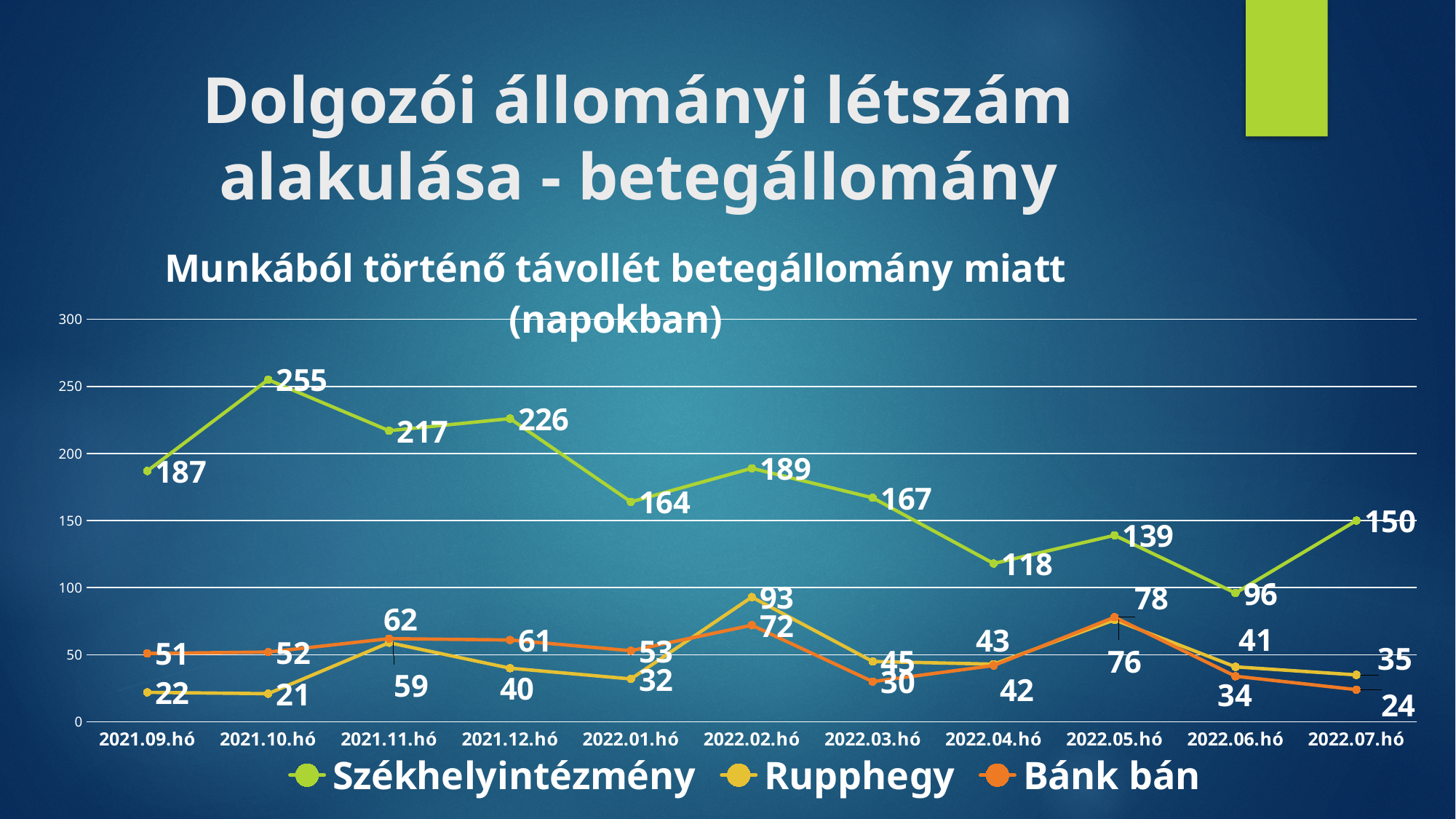
In which month does Székhelyintézmény reach its highest value? 2021.10.hó How many months are plotted along the x axis? 11 What is the value for Bánk bán in 2021.09.hó? 51 What type of chart is shown on the slide? line chart In which month does Székhelyintézmény have its lowest value? 2022.06.hó How many series does the legend list? 3 What is the title of the chart? Munkából történő távollét betegállomány miatt (napokban) What is the value for Székhelyintézmény in 2022.06.hó? 96 What is the value for Rupphegy in 2022.02.hó? 93 What is the value for Székhelyintézmény in 2021.10.hó? 255 What is the difference between the Székhelyintézmény values in 2021.10.hó and 2021.11.hó? 38 Which series has the higher value in 2022.07.hó, Rupphegy or Bánk bán? Rupphegy